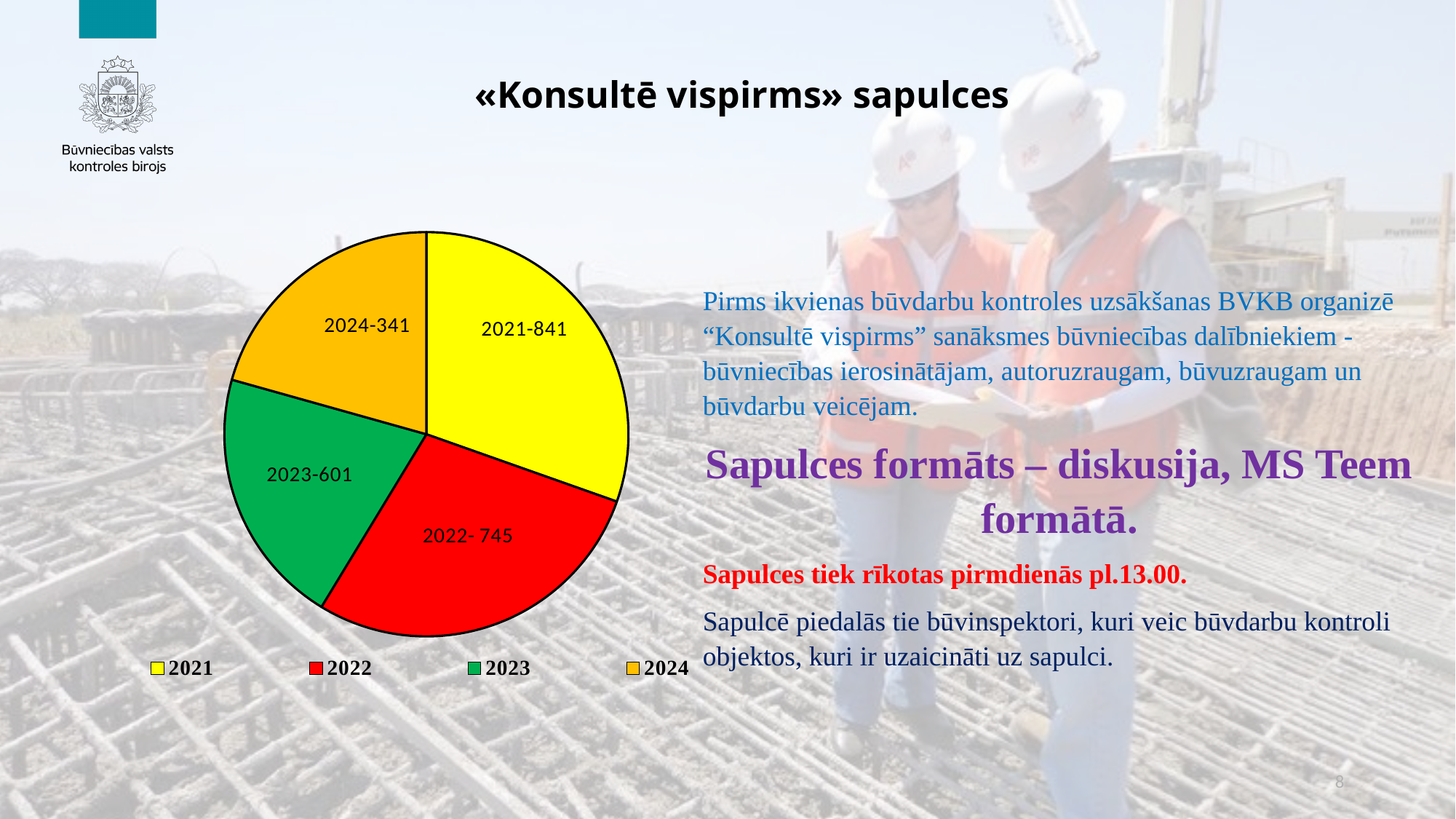
What is the value for 2022 in the pie chart? 745 What is the value for 2024 in the pie chart? 341 Which year has the largest slice in the pie chart? 2021 What type of chart is shown on the slide? pie chart What colour is the slice for 2023 in the pie chart? green What is the value for 2021 in the pie chart? 841 Which is larger, the value for 2022 or the value for 2023? 2022 What is the value for 2023 in the pie chart? 601 Which year has the smallest slice in the pie chart? 2024 What is the difference between the values for 2021 and 2024? 500 What is the difference between the values for 2022 and 2023? 144 How many slices does the pie chart have? 4